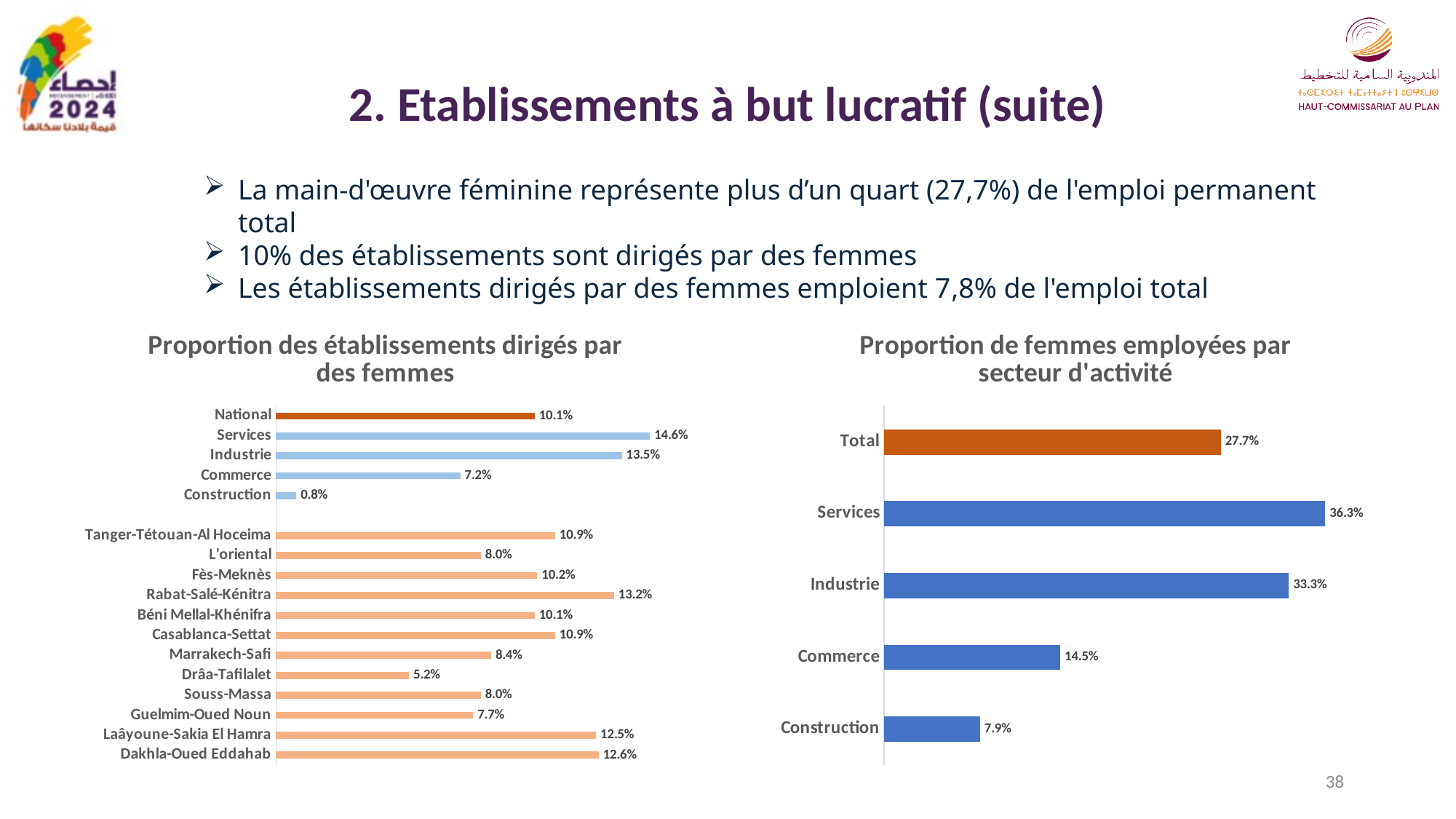
In the chart 'Proportion des établissements dirigés par des femmes', how many regions are listed? 12 In the chart 'Proportion des établissements dirigés par des femmes', which sector has the highest value? Services In the chart 'Proportion des établissements dirigés par des femmes', what is the difference between Services and Commerce? 7.4% In the chart 'Proportion de femmes employées par secteur d'activité', what is the difference between Services and Total? 8.6% In the chart 'Proportion de femmes employées par secteur d'activité', which sector has the highest value? Services In the chart 'Proportion de femmes employées par secteur d'activité', which sector has the lowest value? Construction In the chart 'Proportion des établissements dirigés par des femmes', what is the value for Rabat-Salé-Kénitra? 13.2% In the chart 'Proportion de femmes employées par secteur d'activité', which is larger, Commerce or Construction? Commerce In the chart 'Proportion de femmes employées par secteur d'activité', what is the value for Industrie? 33.3% What type of chart is 'Proportion de femmes employées par secteur d'activité'? Bar chart In the chart 'Proportion des établissements dirigés par des femmes', what is the value for Construction? 0.8% In the chart 'Proportion des établissements dirigés par des femmes', which region has the lowest value? Drâa-Tafilalet